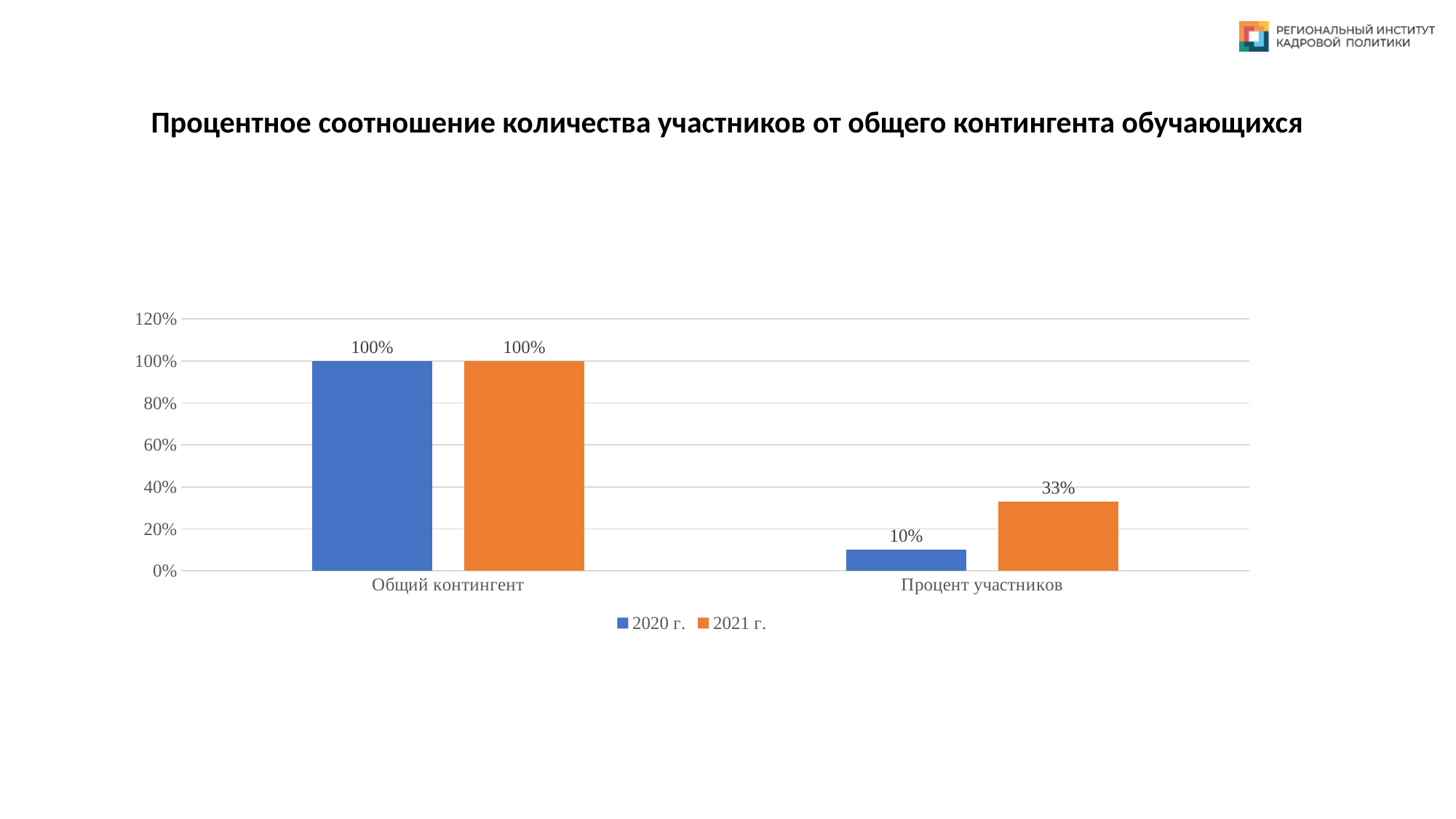
What kind of chart is shown on the slide? bar chart How many categories are shown on the x axis? 2 What is the value for 2020 г. in the Общий контингент category? 100% Which series has the lower value in the Процент участников category? 2020 г. Is the value for 2021 г. in the Процент участников category greater or less than 40%? less What is the value for 2021 г. in the Процент участников category? 33% What is the value for 2021 г. in the Общий контингент category? 100% What is the value for 2020 г. in the Процент участников category? 10% What is the difference between the 2021 г. and 2020 г. values in the Процент участников category? 23% Which is larger in the Процент участников category: the value for 2020 г. or for 2021 г.? 2021 г. How many series does the legend list? 2 Which series is shown in orange in the legend? 2021 г.